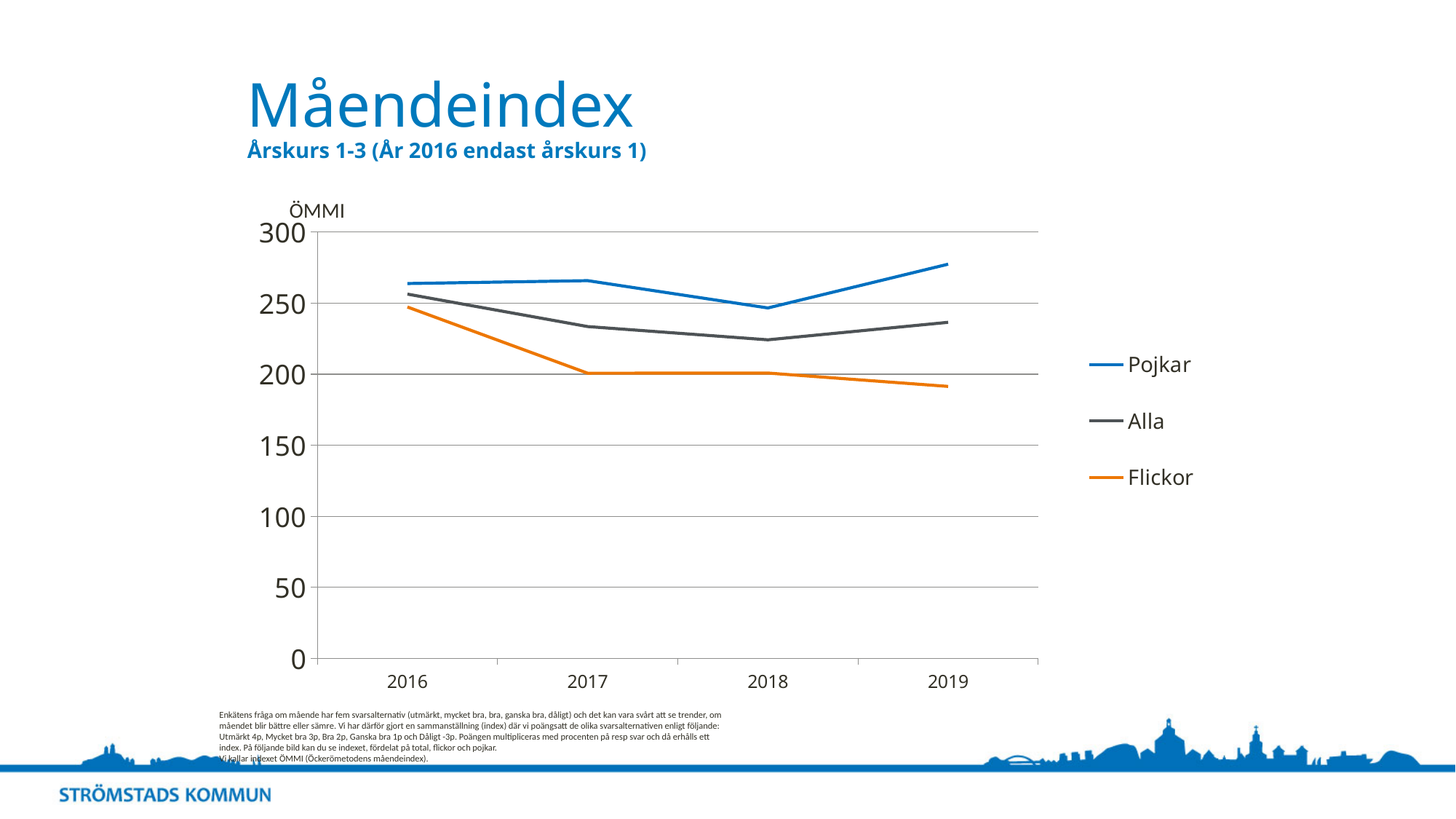
Is the value for Flickor in 2019 greater or less than 200? less In 2019, which series has the larger value, Pojkar or Flickor? Pojkar What label is shown at the top of the vertical axis? ÖMMI Does the Flickor series generally rise or fall from 2016 to 2019? fall In which year does the Alla series reach its lowest value? 2018 Is the value for Pojkar in 2019 greater or less than 250? greater Is the value for Pojkar in 2016 greater or less than 250? greater How many years are shown on the x axis? 4 In which year does the Pojkar series reach its highest value? 2019 How many series does the legend list? 3 What kind of chart is shown on the slide? line chart